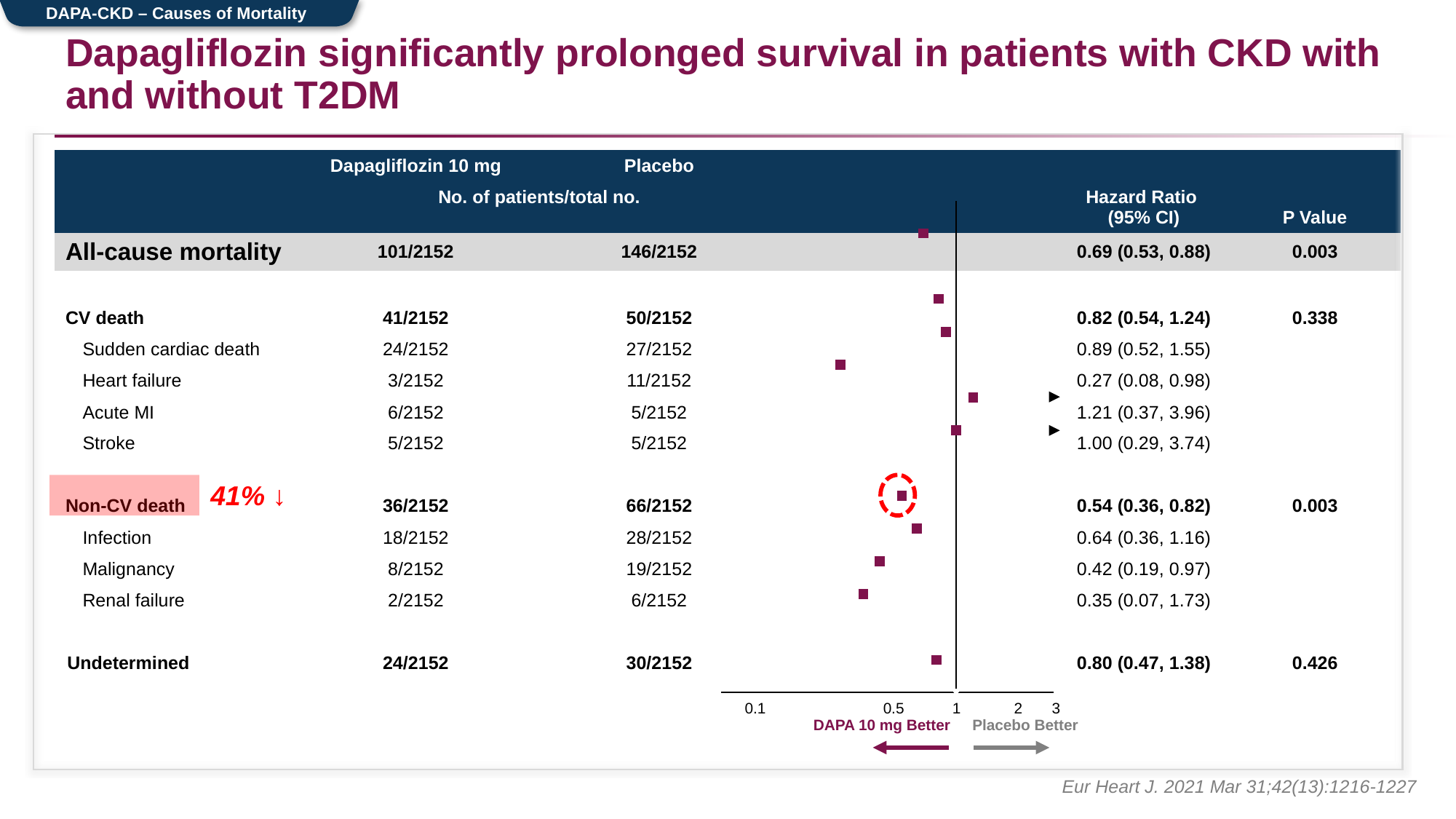
Is the hazard ratio for acute MI greater or less than 1? greater What is the hazard ratio for non-CV death? 0.54 (0.36, 0.82) Which cause of death has the highest hazard ratio? Acute MI What is the P value for CV death? 0.338 Which has the larger hazard ratio, infection or malignancy? Infection How many patients in the placebo group had all-cause mortality? 146/2152 Which cause of death has the lowest hazard ratio? Heart failure What kind of chart is shown on the slide? Forest plot Is the hazard ratio for heart failure greater or less than 0.5? less What is the hazard ratio (95% CI) for all-cause mortality? 0.69 (0.53, 0.88) How many mortality categories are plotted in the forest plot? 11 How many more all-cause deaths occurred in the placebo group than in the dapagliflozin 10 mg group? 45